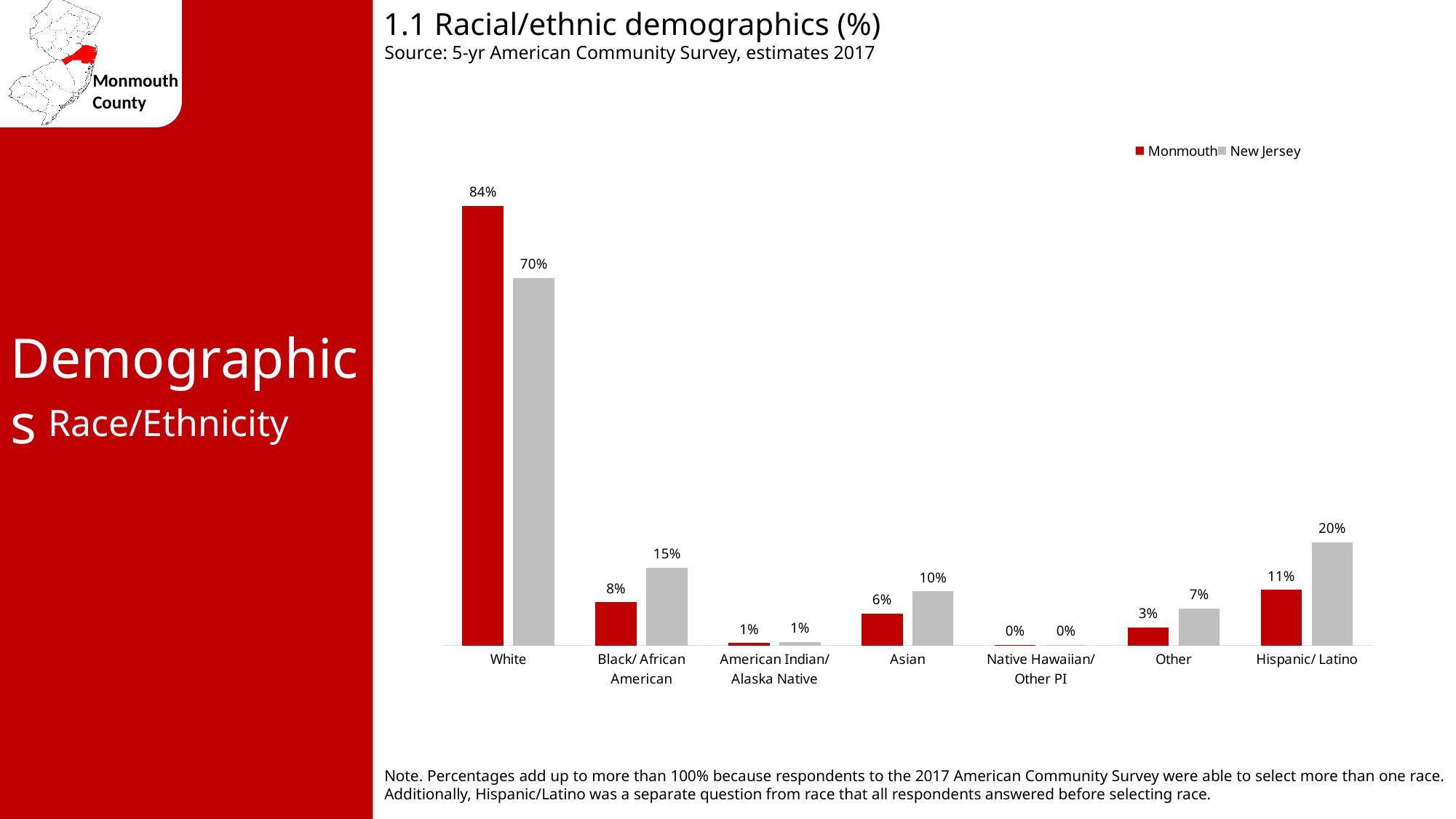
What is the difference between the New Jersey and Monmouth values for Hispanic/ Latino? 9% What is the difference between the Monmouth and New Jersey values for White? 14% Which category has the highest Monmouth value? White What is the Monmouth value for Asian? 6% Which is larger for Other: the Monmouth value or the New Jersey value? New Jersey What is the New Jersey value for Black/ African American? 15% What is the New Jersey value for Hispanic/ Latino? 20% Which category has the lowest New Jersey value? Native Hawaiian/ Other PI What is the Monmouth value for White? 84% What kind of chart is shown? Bar chart How many series does the legend list? 2 How many categories are shown on the x axis? 7